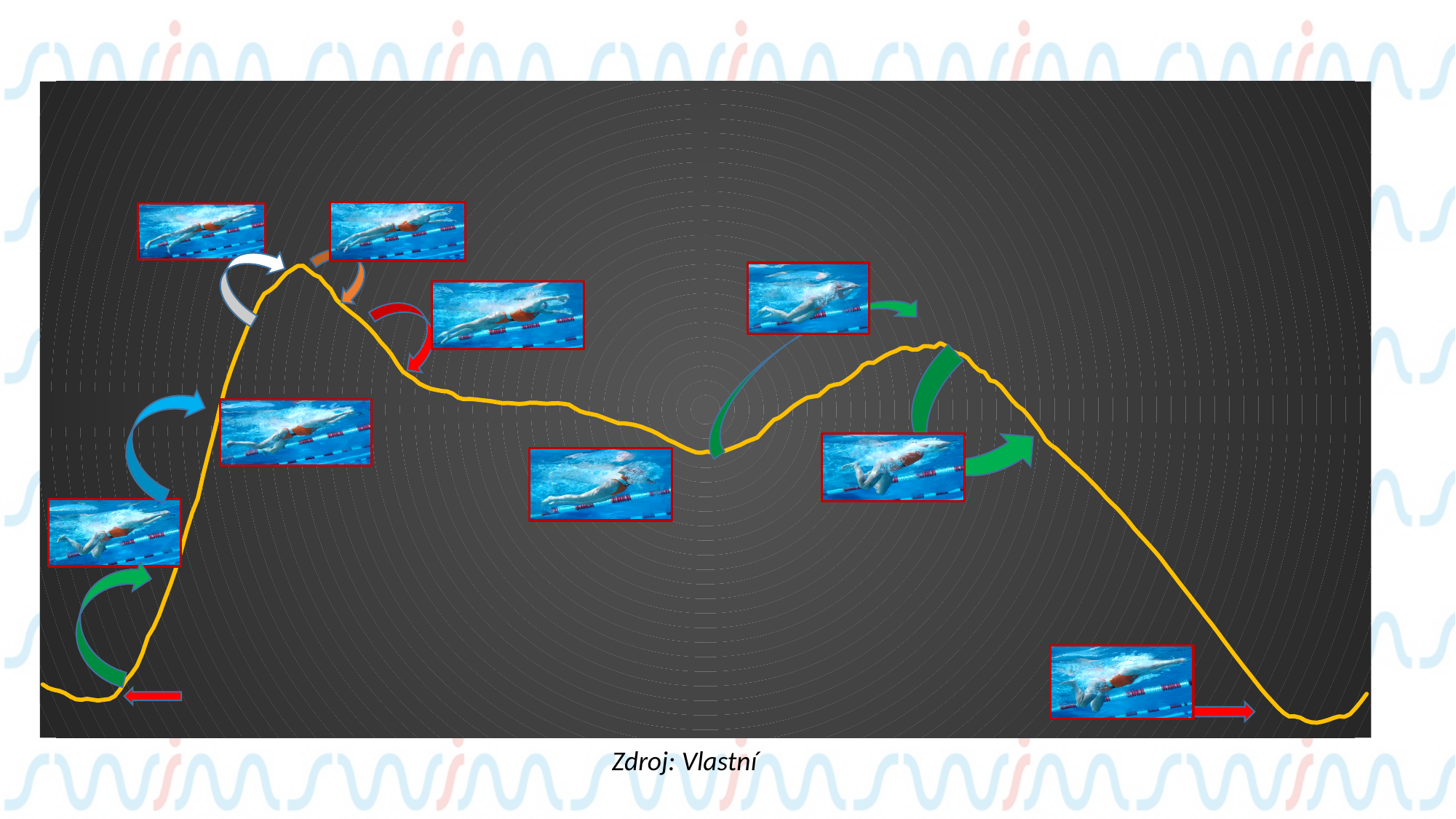
Does the plotted line rise or fall between its first peak and the dip in the middle of the chart? fall What kind of chart is shown on the slide? line chart Does the plotted line rise or fall from the middle dip to the second peak? rise What colour is the plotted line on the chart? yellow What source text is written below the chart? Zdroj: Vlastní Which of the two peaks of the line is higher, the left one or the right one? the left one How many lines (data series) are plotted on the chart? 1 Does the plotted line rise or fall after its second peak towards the right side of the chart? fall How many peaks (high points) does the plotted line have? 2